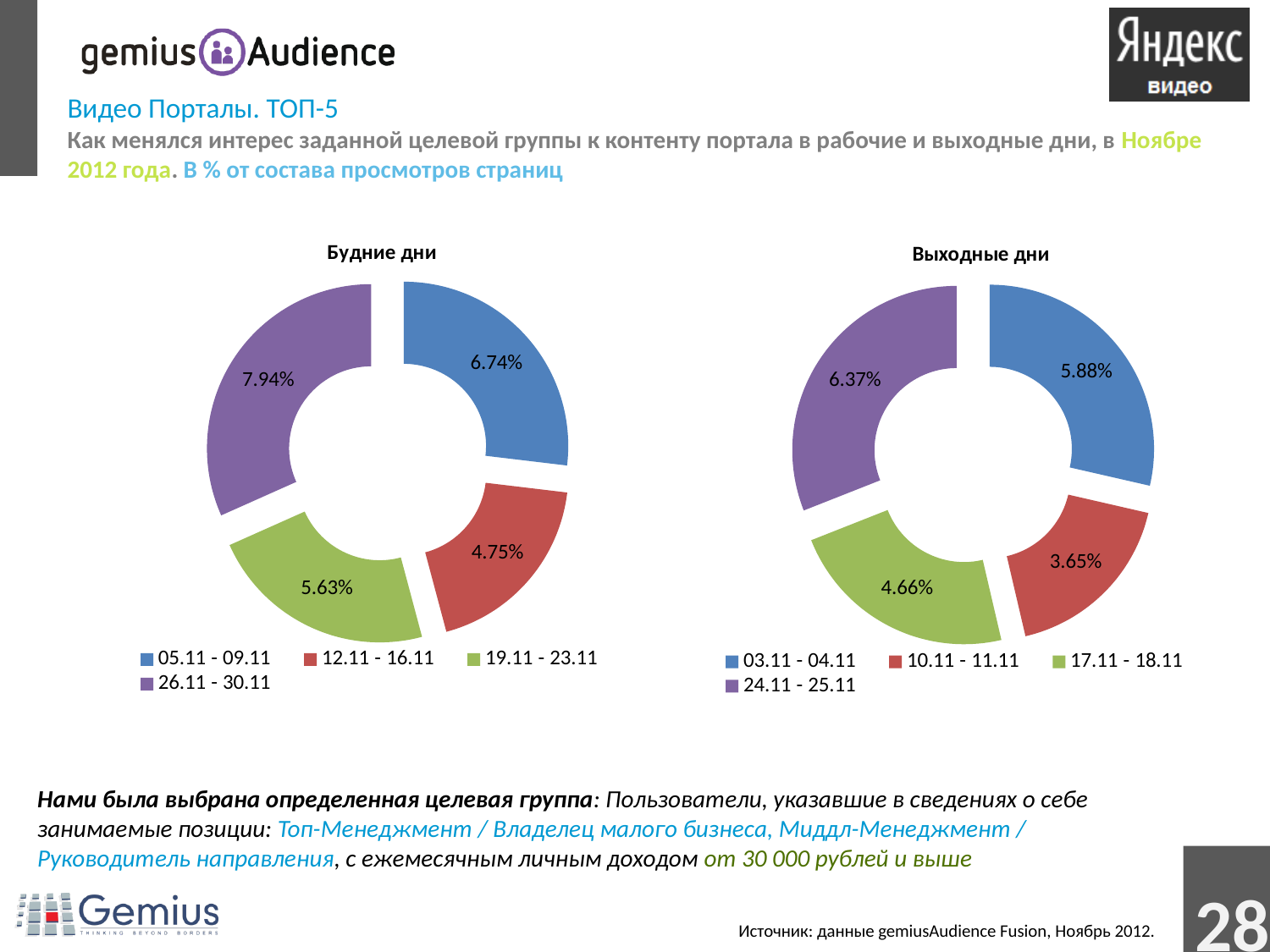
In the 'Будние дни' chart, what is the difference between the values for 26.11 - 30.11 and 12.11 - 16.11? 3.19% In the 'Будние дни' chart, what is the value for 19.11 - 23.11? 5.63% In the 'Выходные дни' chart, which is larger: the value for 03.11 - 04.11 or the value for 17.11 - 18.11? 03.11 - 04.11 In the 'Будние дни' chart, which period has the highest value? 26.11 - 30.11 In the 'Выходные дни' chart, what is the value for 24.11 - 25.11? 6.37% In the 'Выходные дни' chart, which period has the highest value? 24.11 - 25.11 In the 'Выходные дни' chart, what is the value for 10.11 - 11.11? 3.65% What type of chart is the 'Будние дни' chart? Doughnut chart How many periods does the legend of the 'Выходные дни' chart list? 4 In the 'Выходные дни' chart, which period has the lowest value? 10.11 - 11.11 In the 'Будние дни' chart, which period has the lowest value? 12.11 - 16.11 In the 'Будние дни' chart, what is the value for 05.11 - 09.11? 6.74%